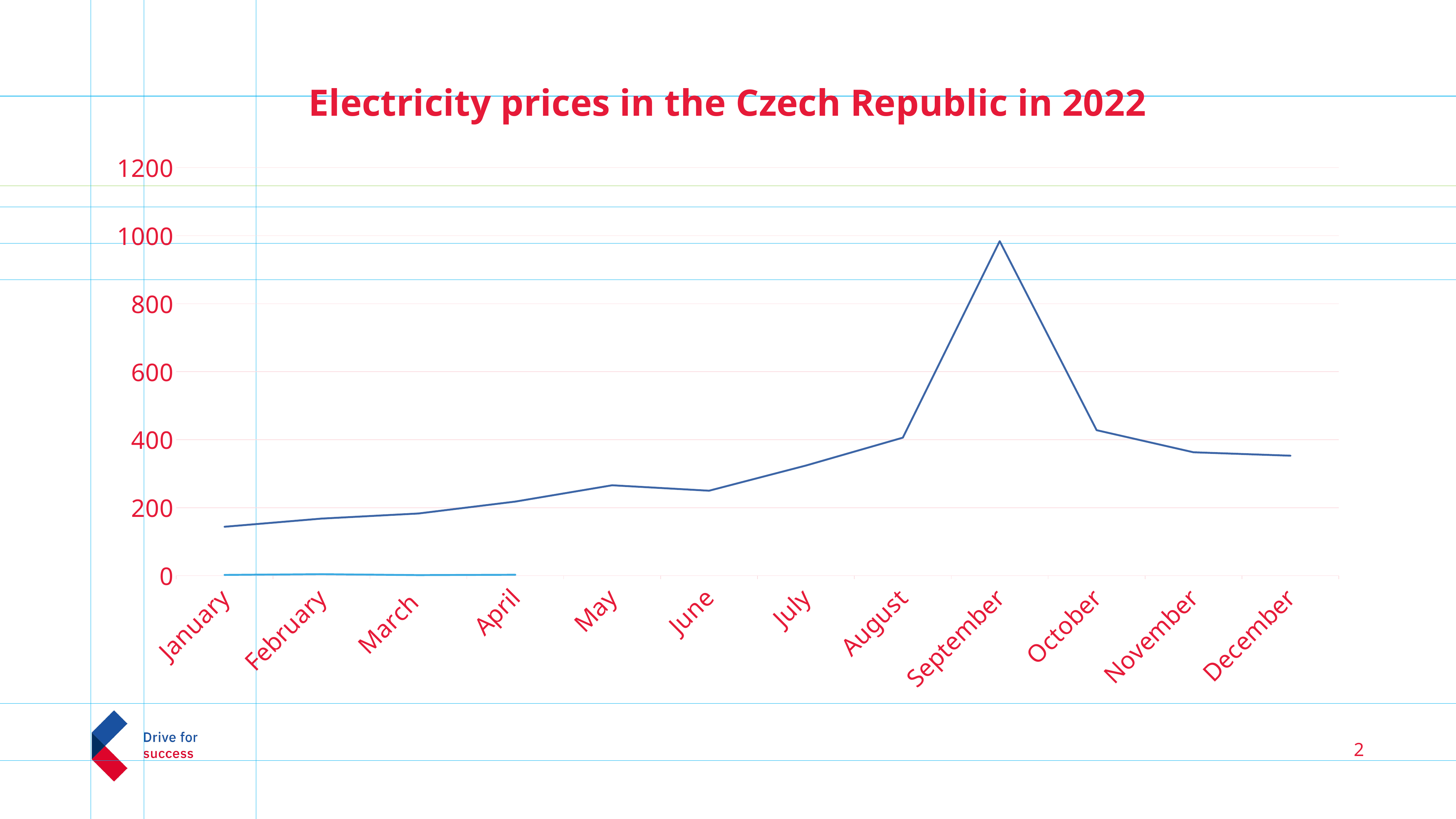
What is the title of the chart? Electricity prices in the Czech Republic in 2022 In which month does the dark blue line reach its highest value? September Is the value for January greater or less than 200? less Is the value for October greater or less than 600? less How many months are shown on the x axis of the chart? 12 Which month has the higher value, September or October? September Is the value for July greater or less than 200? greater Do the values on the dark blue line rise or fall from January to April? rise What kind of chart is shown on the slide? line chart In which month does the dark blue line have its lowest value? January Which month has the higher value, January or May? May